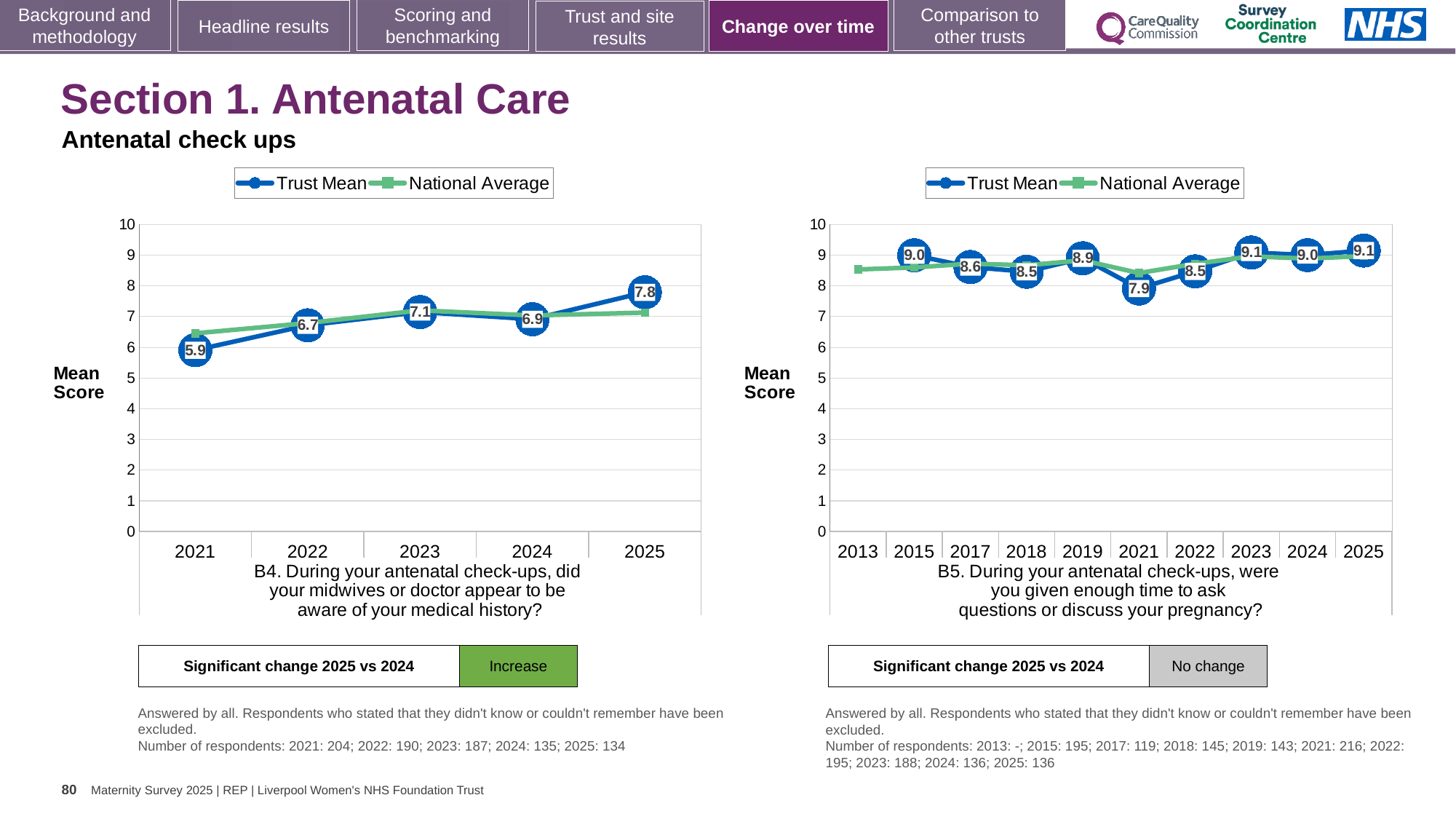
In the right chart (B5), what is the difference between the Trust Mean for 2015 and 2017? 0.4 How many series does the legend of the left chart (B4) list? 2 In the right chart (B5), what is the Trust Mean for 2021? 7.9 In the left chart (B4), what is the Trust Mean for 2025? 7.8 In the left chart (B4), what is the difference between the Trust Mean for 2025 and 2024? 0.9 In the left chart (B4), how many years are shown on the x axis? 5 In the right chart (B5), is the National Average for 2013 greater or less than 8? greater In the right chart (B5), which year has the lowest Trust Mean? 2021 In the left chart (B4), what is the Trust Mean for 2021? 5.9 In the right chart (B5), is the Trust Mean for 2023 larger or smaller than for 2018? larger In the left chart (B4), which year has the lowest Trust Mean? 2021 What kind of chart is the right chart (B5)? line chart